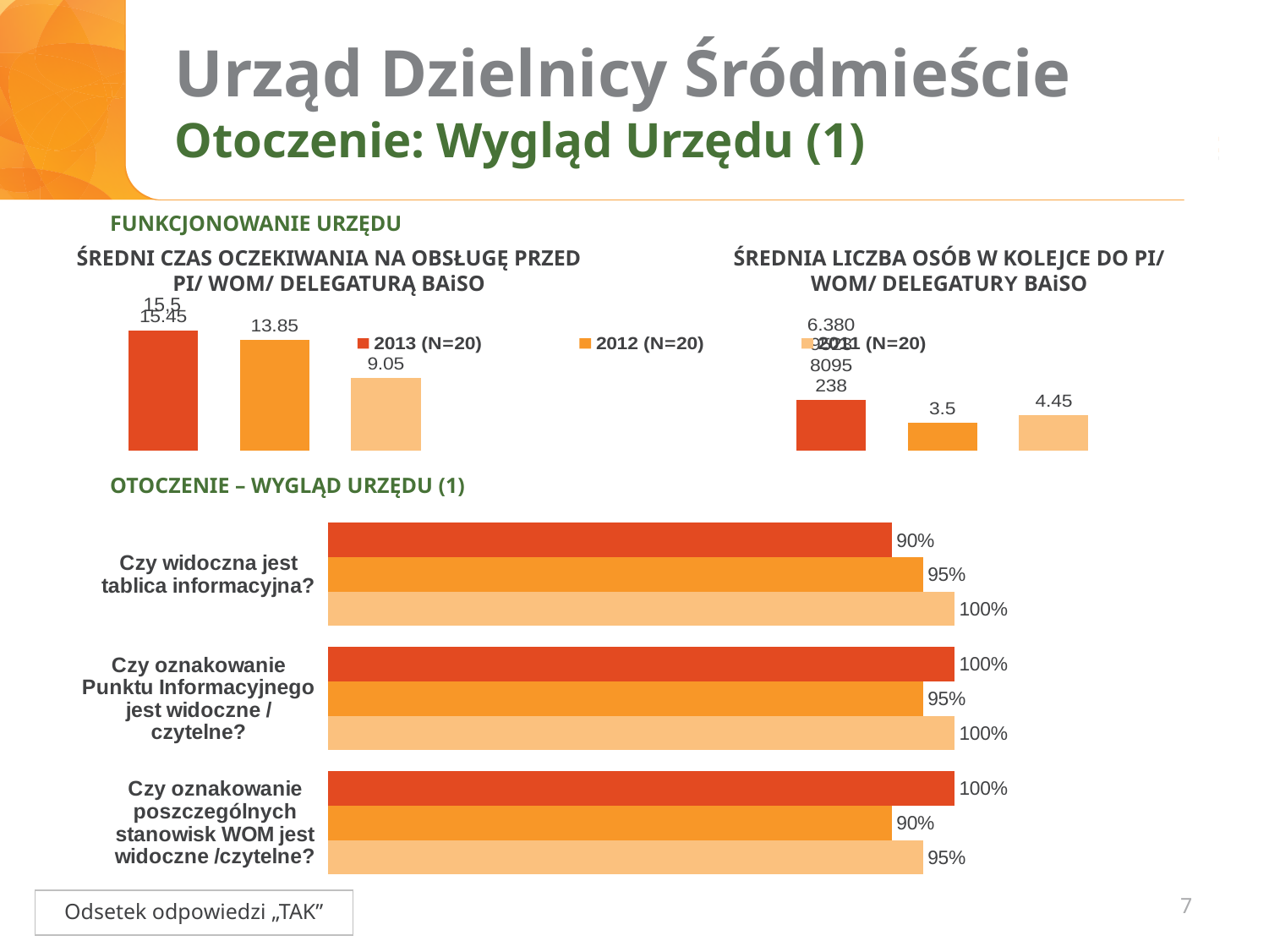
In the bottom chart 'OTOCZENIE – WYGLĄD URZĘDU (1)', what is the value of the middle (orange) bar for 'Czy oznakowanie Punktu Informacyjnego jest widoczne / czytelne?'? 95% What type of chart is the bottom chart 'OTOCZENIE – WYGLĄD URZĘDU (1)'? bar chart In the chart 'ŚREDNIA LICZBA OSÓB W KOLEJCE DO PI/ WOM/ DELEGATURY BAiSO', which is larger: the orange (middle) bar or the light orange (third) bar? the light orange (third) bar, 4.45 In the chart 'ŚREDNI CZAS OCZEKIWANIA NA OBSŁUGĘ PRZED PI/ WOM/ DELEGATURĄ BAiSO', which bar is the lowest? the light orange (third) bar, 9.05 In the bottom chart 'OTOCZENIE – WYGLĄD URZĘDU (1)', what is the value of the top (dark red-orange) bar for 'Czy widoczna jest tablica informacyjna?'? 90% In the chart 'ŚREDNI CZAS OCZEKIWANIA NA OBSŁUGĘ PRZED PI/ WOM/ DELEGATURĄ BAiSO', what is the value of the 2012 (orange) bar? 13.85 In the bottom chart 'OTOCZENIE – WYGLĄD URZĘDU (1)', what is the value of the middle (orange) bar for 'Czy oznakowanie poszczególnych stanowisk WOM jest widoczne /czytelne?'? 90% In the chart 'ŚREDNI CZAS OCZEKIWANIA NA OBSŁUGĘ PRZED PI/ WOM/ DELEGATURĄ BAiSO', what is the value of the light orange (third) bar? 9.05 In the bottom chart 'OTOCZENIE – WYGLĄD URZĘDU (1)', what is the difference between the bottom (light orange) bar and the top (dark red-orange) bar for 'Czy widoczna jest tablica informacyjna?'? 10% In the chart 'ŚREDNIA LICZBA OSÓB W KOLEJCE DO PI/ WOM/ DELEGATURY BAiSO', what is the value of the 2012 (orange) bar? 3.5 In the bottom chart 'OTOCZENIE – WYGLĄD URZĘDU (1)', what is the value of the bottom (light orange) bar for 'Czy widoczna jest tablica informacyjna?'? 100% In the bottom chart 'OTOCZENIE – WYGLĄD URZĘDU (1)', how many question categories are shown? 3